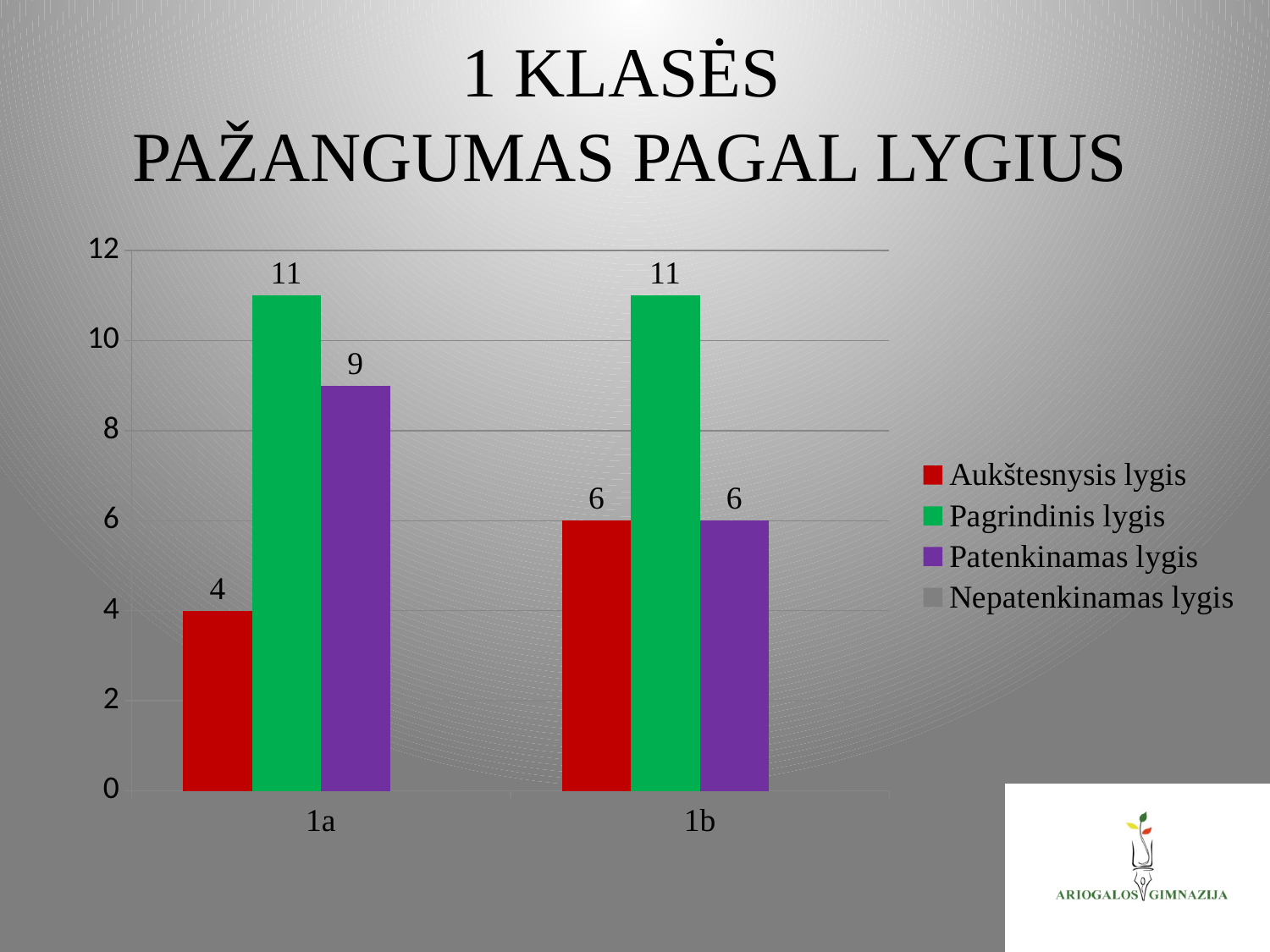
What is the value for Pagrindinis lygis in class 1b? 11 What is the value for Patenkinamas lygis in class 1a? 9 What kind of chart is shown on the slide? bar chart What is the value for Aukštesnysis lygis in class 1b? 6 Which series has the highest value in class 1a? Pagrindinis lygis What colour represents Pagrindinis lygis in the chart? green What is the value for Aukštesnysis lygis in class 1a? 4 What is the difference between Patenkinamas lygis in class 1a and in class 1b? 3 How many classes (categories) are shown on the x axis? 2 How many series does the legend list? 4 Which is larger: Aukštesnysis lygis in class 1a or in class 1b? 1b